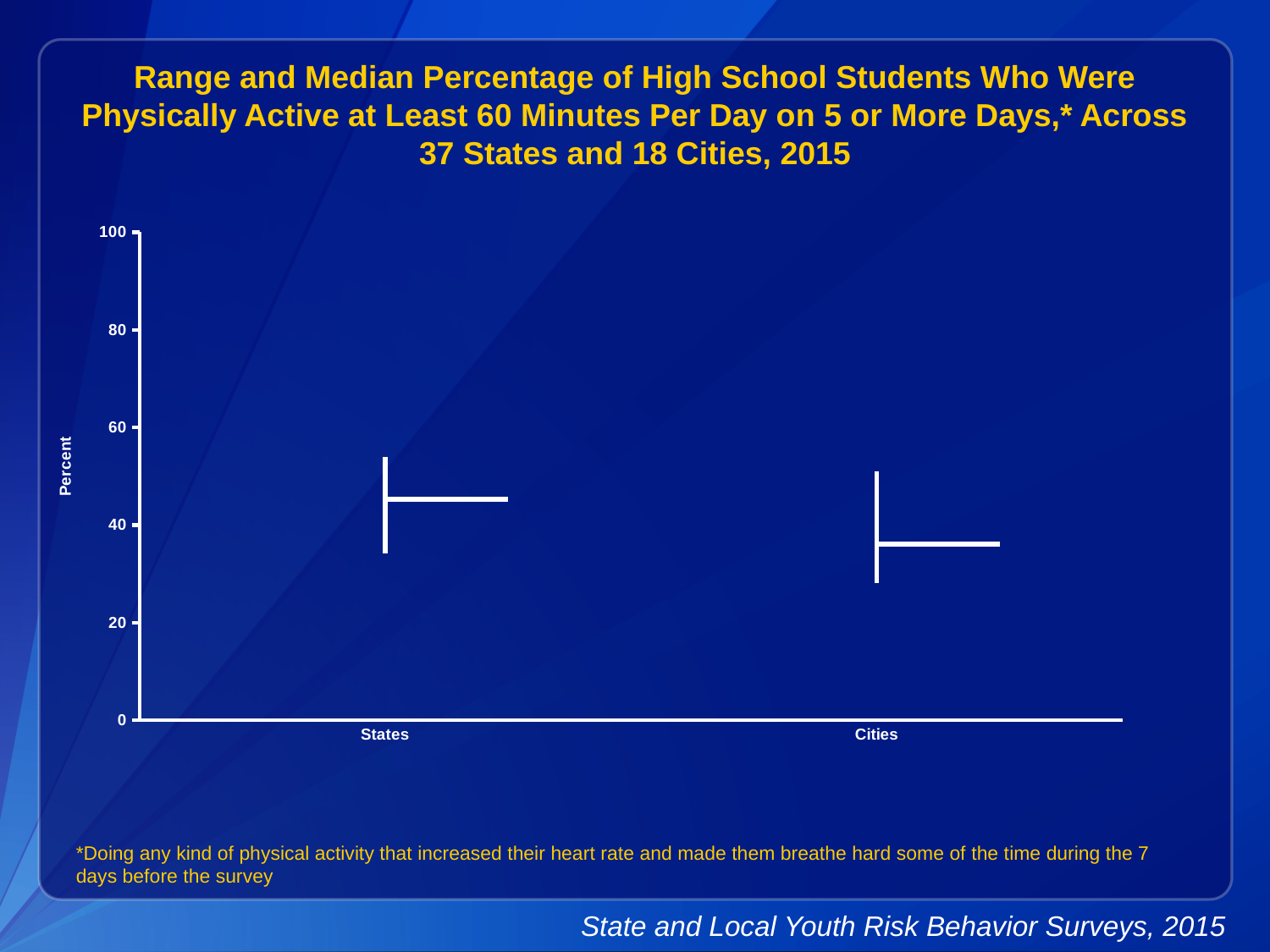
Is the median value for States greater or less than 40? greater What is the maximum value shown on the y axis? 100 Is the top of the range for Cities greater or less than 40? greater Is the median value for Cities greater or less than 40? less Which category's range extends lower on the chart, States or Cities? Cities How many categories are shown on the x axis of the chart? 2 What is the label on the y axis of the chart? Percent Which category has the higher median percentage, States or Cities? States Which category has the lowest median percentage? Cities